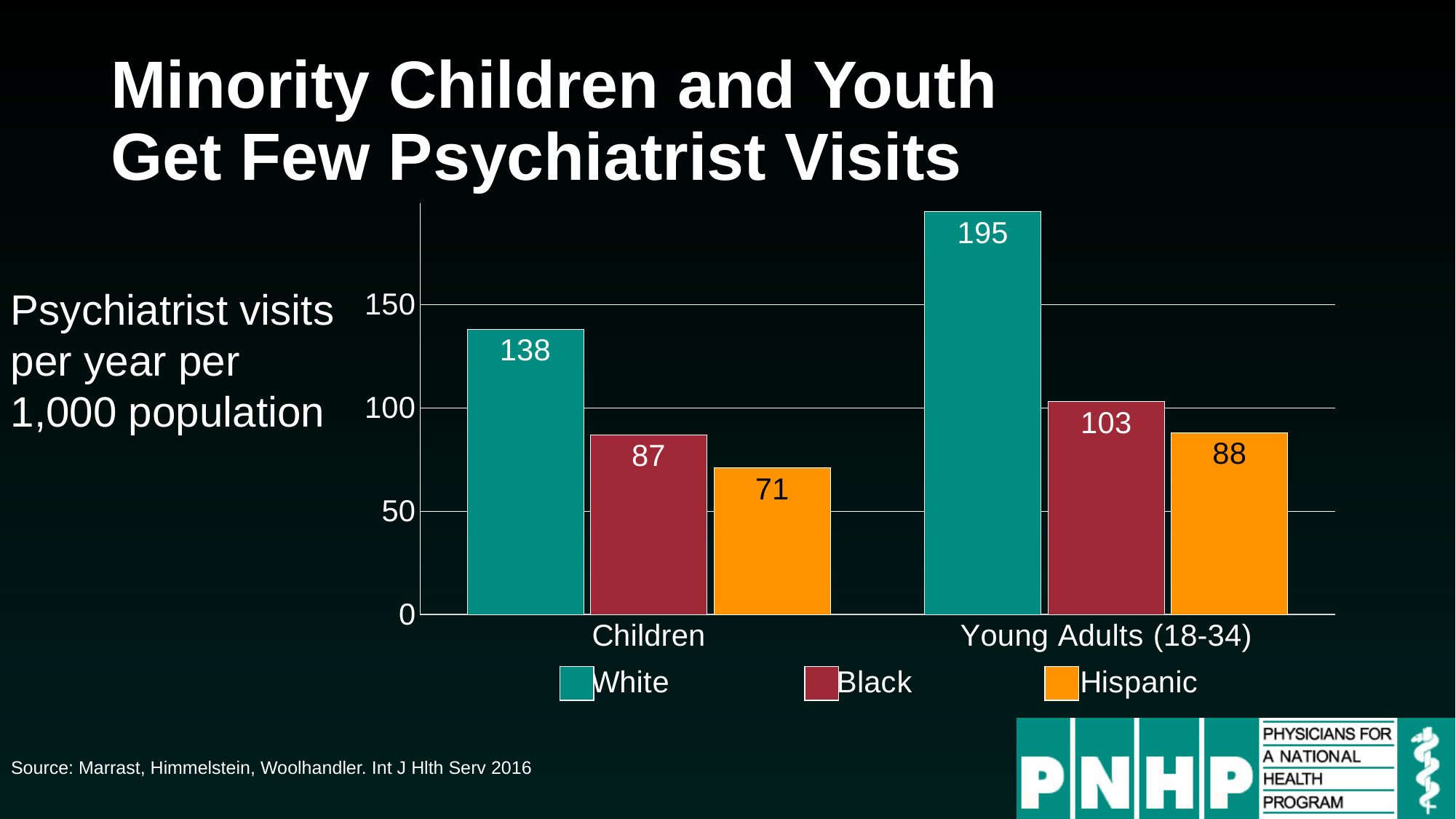
What is the difference between the White values for Young Adults (18-34) and Children? 57 What does the y axis of the chart measure? Psychiatrist visits per year per 1,000 population What is the value for White in the Children group? 138 Is the value for White in the Young Adults (18-34) group greater or less than 150? greater What is the value for Hispanic in the Young Adults (18-34) group? 88 How many series does the legend list? 3 Which series has the lowest value in the Children group? Hispanic Which is larger, the Black value for Children or the Hispanic value for Young Adults (18-34)? Hispanic value for Young Adults (18-34) Which series has the highest value in the Young Adults (18-34) group? White What is the difference between the White and Black values in the Young Adults (18-34) group? 92 What is the value for Black in the Children group? 87 What kind of chart is shown on the slide? bar chart